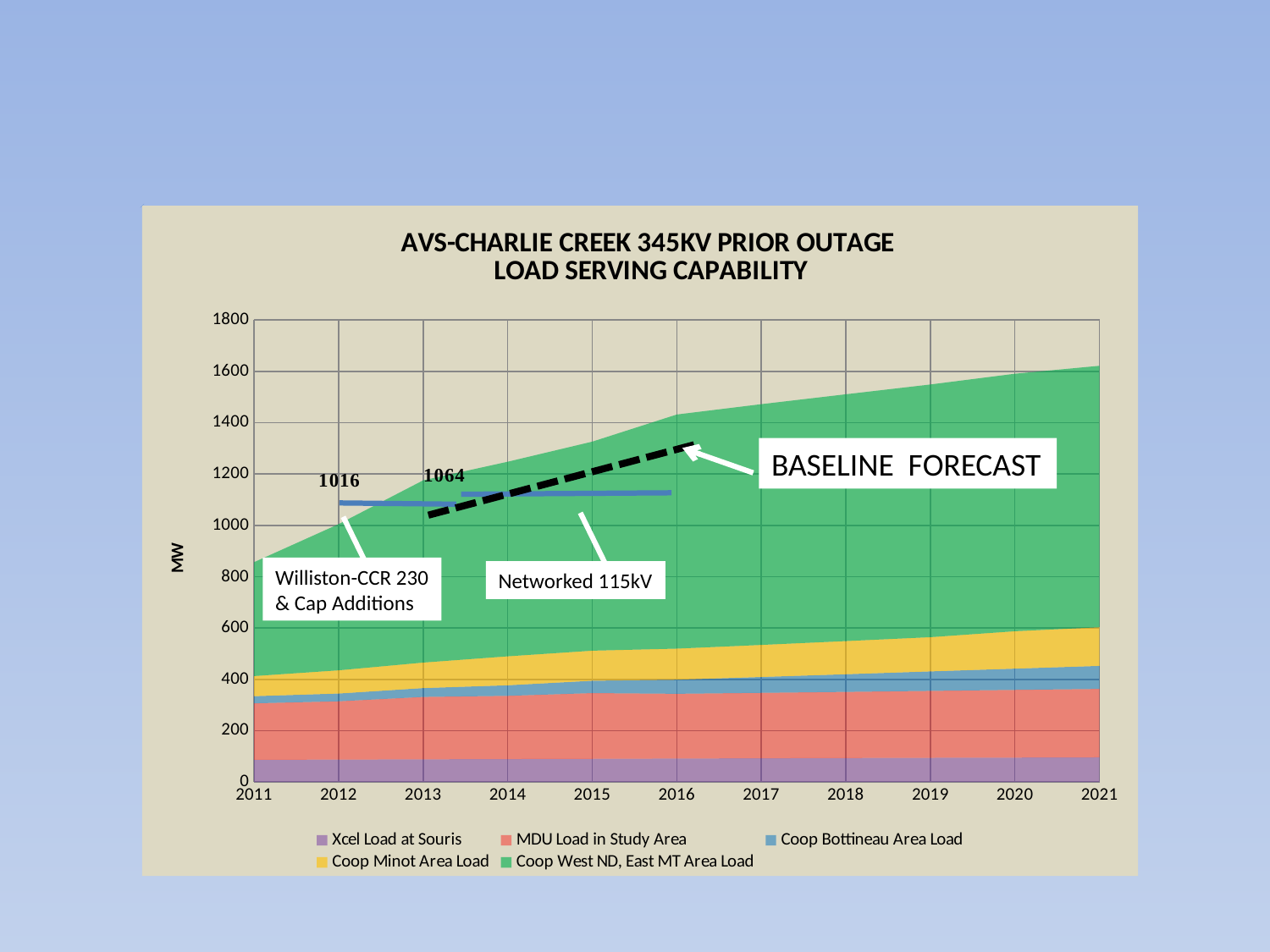
What value is labeled on the Networked 115kV line? 1064 What is the label on the y axis? MW What kind of chart is shown on the slide? Stacked area chart Which is larger, the labeled value for Networked 115kV or for Williston-CCR 230 & Cap Additions? Networked 115kV Is the total stacked load in 2021 greater or less than 1400 MW? greater How many years are shown along the x axis? 11 Which series occupies the largest area of the chart? Coop West ND, East MT Area Load What value is labeled on the Williston-CCR 230 & Cap Additions line? 1016 What is the difference between the Networked 115kV value (1064) and the Williston-CCR 230 & Cap Additions value (1016)? 48 Does the total load rise or fall from 2011 to 2021? Rises Is the total stacked load in 2011 greater or less than 1000 MW? less How many series does the legend list? 5